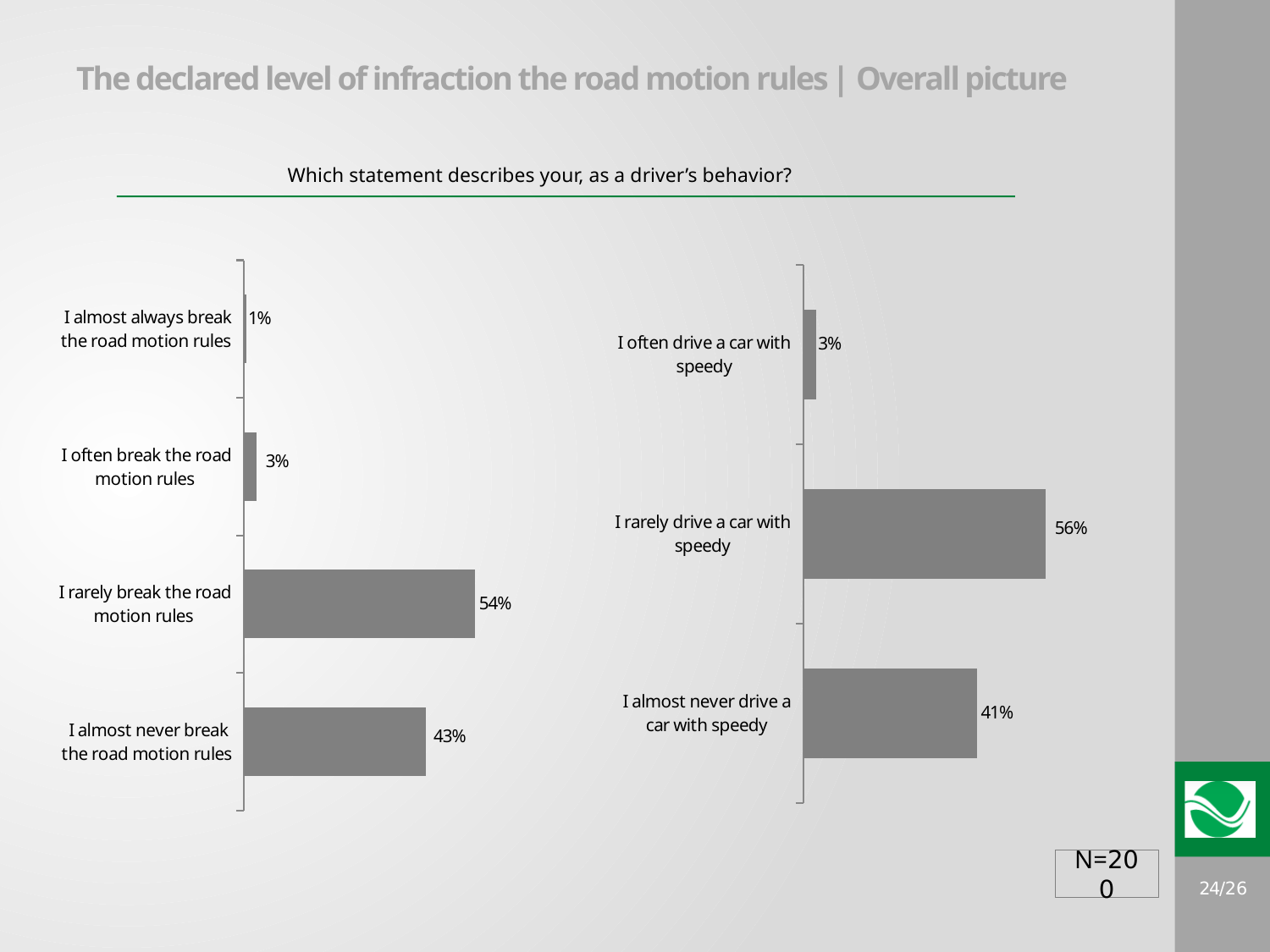
In the right chart, what percentage of respondents say they rarely drive a car with speedy? 56% How many categories are shown in the right chart? 3 In the right chart, what percentage of respondents say they often drive a car with speedy? 3% In the left chart, which is larger: the percentage for 'I often break the road motion rules' or 'I almost always break the road motion rules'? I often break the road motion rules In the right chart, which statement has the highest percentage? I rarely drive a car with speedy How many categories are shown in the left chart? 4 In the left chart, what percentage of respondents say they almost never break the road motion rules? 43% What type of chart is the right chart? Bar chart In the left chart, what is the difference between the percentages for 'I rarely break the road motion rules' and 'I almost never break the road motion rules'? 11% In the left chart, what percentage of respondents say they rarely break the road motion rules? 54% In the left chart, which statement has the lowest percentage? I almost always break the road motion rules In the right chart, what is the difference between the percentages for 'I rarely drive a car with speedy' and 'I almost never drive a car with speedy'? 15%